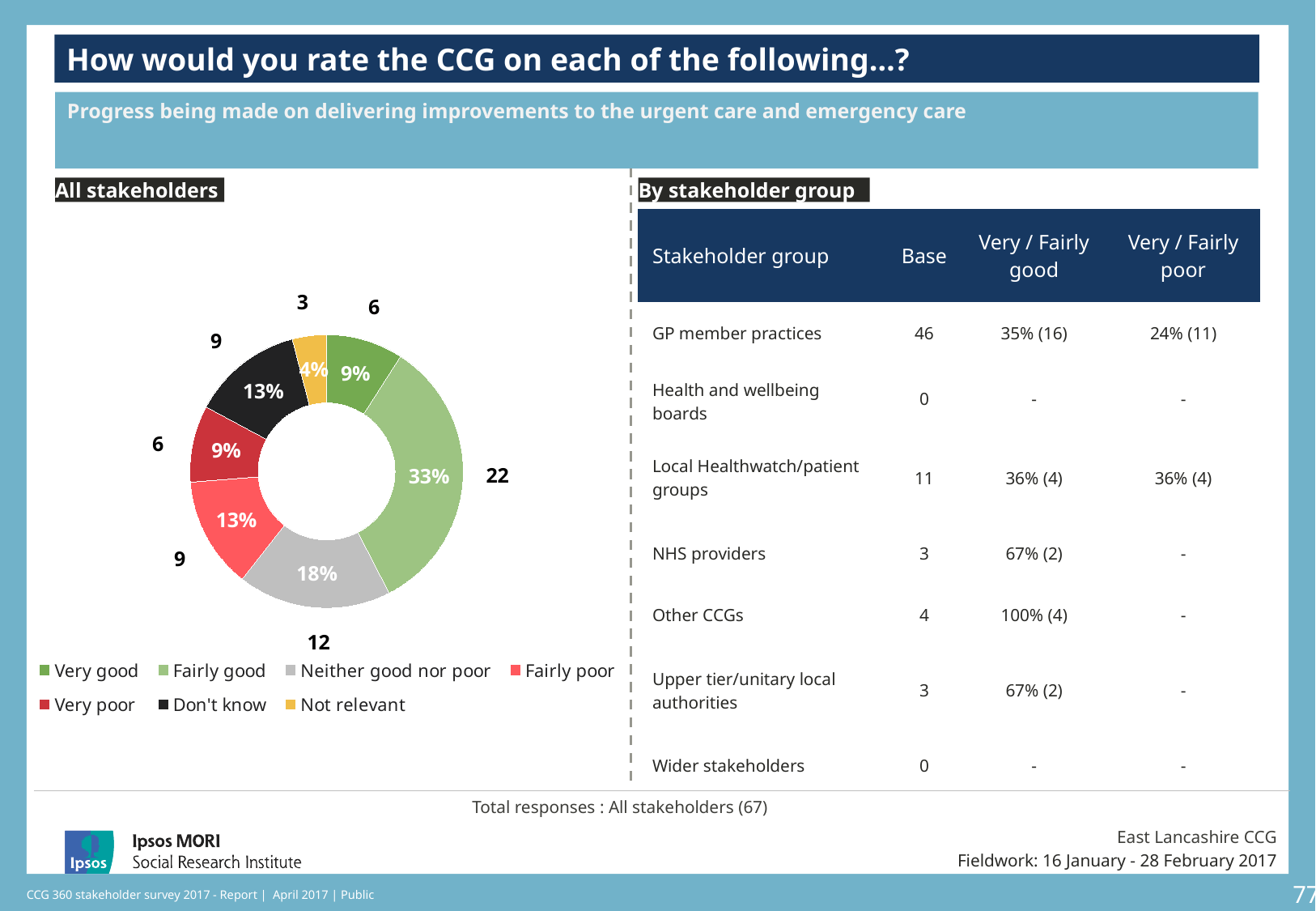
What colour represents 'Very poor' in the All stakeholders chart legend? Dark red What percentage of all stakeholders answered 'Not relevant'? 4% What is the combined number of respondents who answered 'Very good' or 'Fairly good' in the All stakeholders chart? 28 Which category has the smallest share of the All stakeholders donut chart? Not relevant How many respondents answered 'Neither good nor poor' in the All stakeholders chart? 12 What percentage of all stakeholders rated the CCG as 'Fairly good'? 33% Which category has the largest share of the All stakeholders donut chart? Fairly good What type of chart is used to show the All stakeholders results? Donut (pie) chart What is the difference in percentage points between 'Fairly good' and 'Neither good nor poor' in the All stakeholders chart? 15 Which is larger in the All stakeholders chart: 'Fairly poor' or 'Very poor'? Fairly poor What share of the All stakeholders chart is 'Don't know'? 13% How many categories are shown in the All stakeholders donut chart? 7